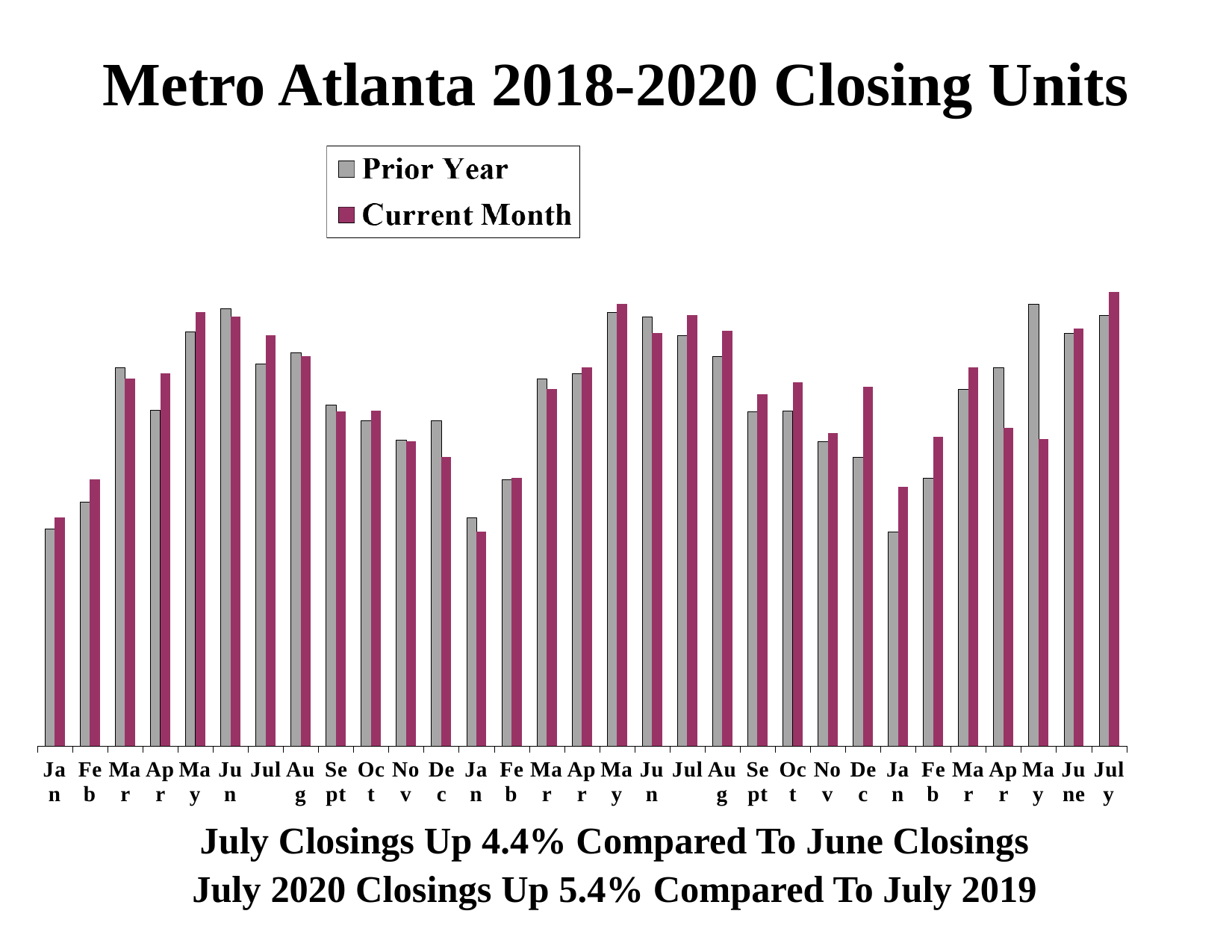
What is the title of the chart? Metro Atlanta 2018-2020 Closing Units For the third January on the x axis, which is larger: Prior Year or Current Month? Current Month What are the two series named in the legend? Prior Year and Current Month For the second December on the x axis, which is larger: Prior Year or Current Month? Current Month Which month has the highest Current Month value? the last July (July 2020) Which month has the lowest Current Month value? the second January (January 2019) For the last April on the x axis, which is larger: Prior Year or Current Month? Prior Year From the first January to the first May on the x axis, do the Current Month values rise or fall? rise How many series does the legend list? 2 What kind of chart is shown on the slide? bar chart How many months (categories) are plotted along the x axis? 31